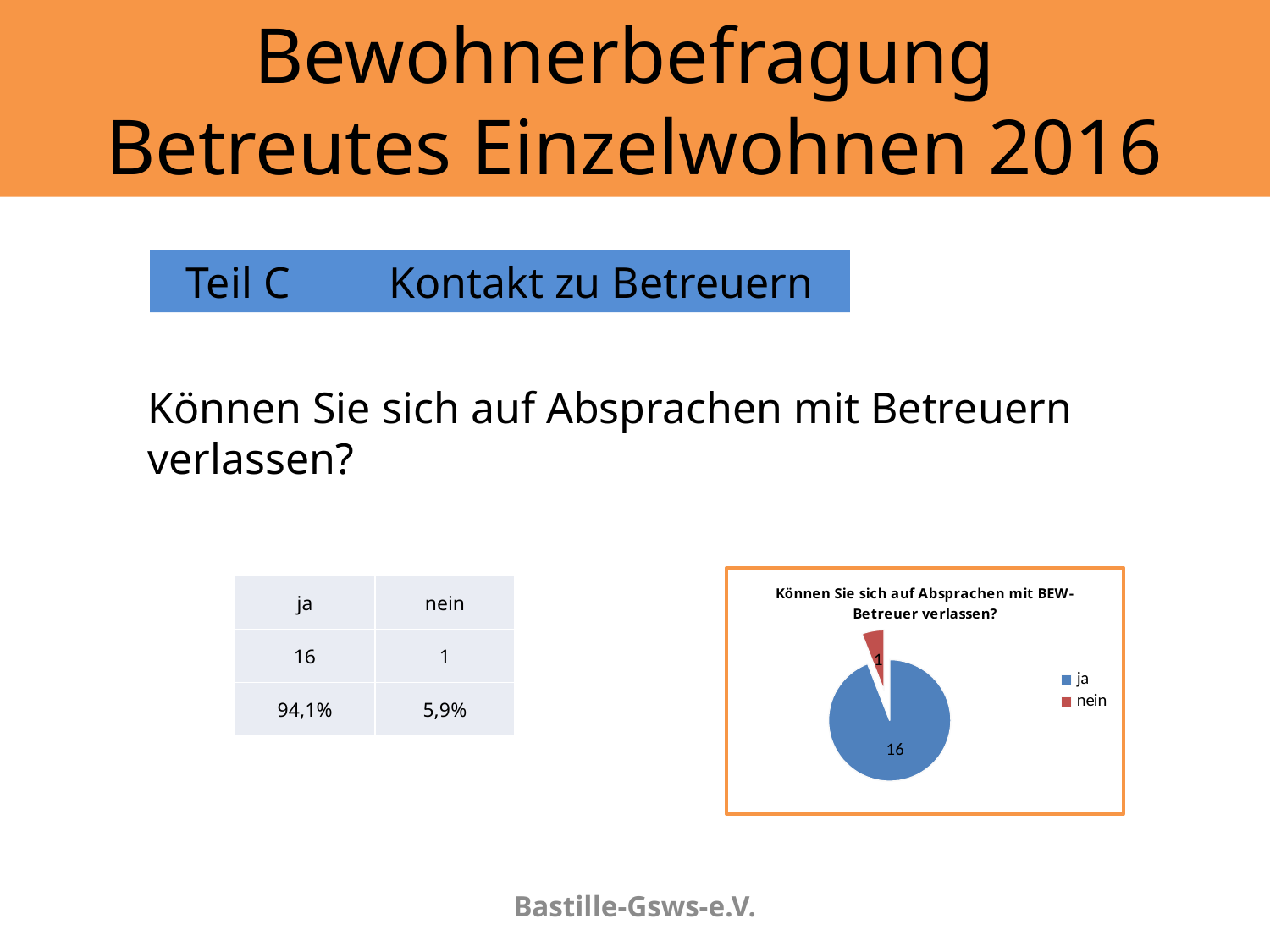
Which is larger in the pie chart, "ja" or "nein"? ja What is the difference between the values for "ja" and "nein" in the pie chart? 15 What colour is the "nein" slice in the pie chart? red What is the value for "ja" in the pie chart? 16 Which category has the smallest slice in the pie chart? nein Which category has the largest slice in the pie chart? ja What is the title of the pie chart? Können Sie sich auf Absprachen mit BEW-Betreuer verlassen? What is the value for "nein" in the pie chart? 1 What kind of chart is shown on the slide? pie chart How many slices does the pie chart have? 2 How many entries does the legend of the pie chart list? 2 What is the total of all slices in the pie chart? 17